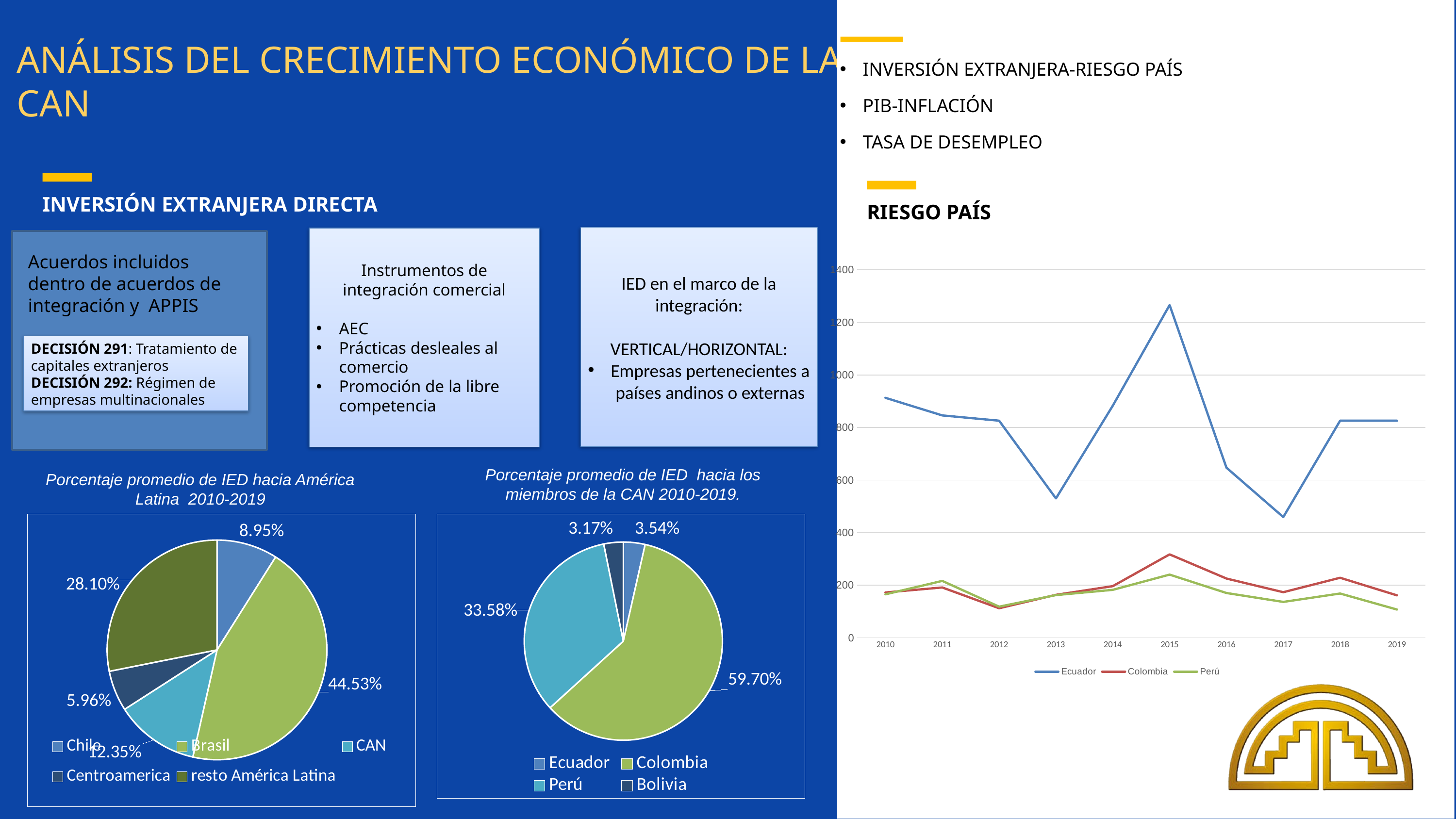
How many series does the legend of the 'RIESGO PAÍS' chart list? 3 In the 'RIESGO PAÍS' chart, is the value for Ecuador in 2015 greater or less than 1200? greater In the pie chart 'Porcentaje promedio de IED hacia América Latina 2010-2019', how many categories are shown? 5 In the pie chart 'Porcentaje promedio de IED hacia América Latina 2010-2019', what is the value for CAN? 12.35% In the pie chart 'Porcentaje promedio de IED hacia América Latina 2010-2019', what is the value for Brasil? 44.53% In the pie chart 'Porcentaje promedio de IED hacia los miembros de la CAN 2010-2019', which is larger, Ecuador or Bolivia? Ecuador What kind of chart is the 'RIESGO PAÍS' chart? Line chart In the pie chart 'Porcentaje promedio de IED hacia América Latina 2010-2019', which category has the smallest share? Centroamerica In the pie chart 'Porcentaje promedio de IED hacia los miembros de la CAN 2010-2019', which country has the largest share? Colombia In the pie chart 'Porcentaje promedio de IED hacia los miembros de la CAN 2010-2019', what is the difference between Colombia and Perú? 26.12% In the 'RIESGO PAÍS' chart, in which year does Ecuador reach its highest value? 2015 In the pie chart 'Porcentaje promedio de IED hacia los miembros de la CAN 2010-2019', what is the value for Perú? 33.58%